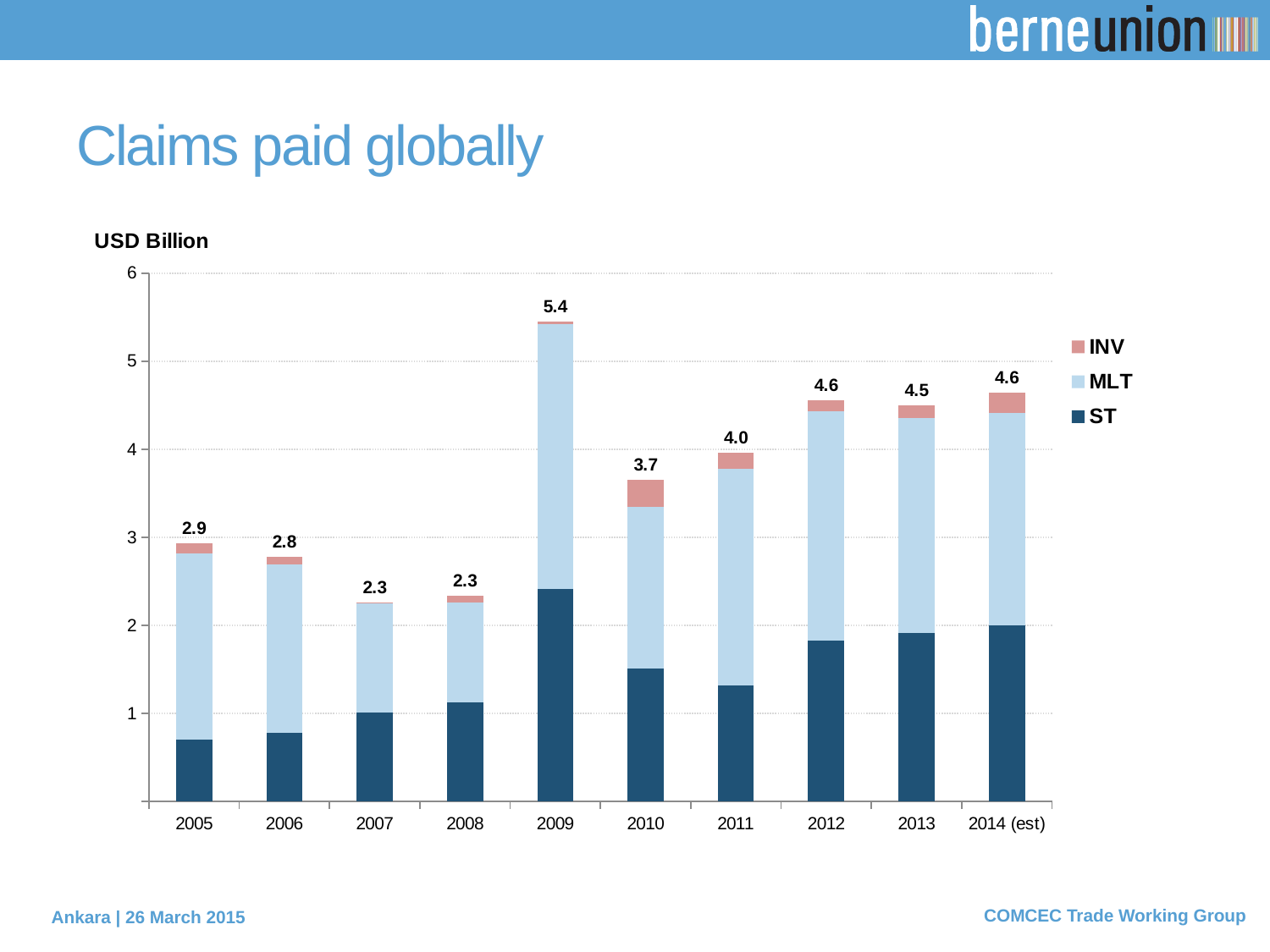
Is the ST segment for 2005 greater or less than 1? less What unit is stated for the values on the chart? USD Billion What is the total claims paid value shown for 2009? 5.4 What kind of chart is shown on the slide? Stacked bar chart What is the total value shown for 2010? 3.7 Is the ST segment for 2009 greater or less than 2? greater What is the difference between the total for 2009 and the total for 2005? 2.5 Which year has the highest total claims paid? 2009 Which is larger, the total for 2011 or the total for 2013? 2013 How many series does the legend list? 3 How many years are shown on the x axis? 10 What is the total value labelled above the bar for 2014 (est)? 4.6